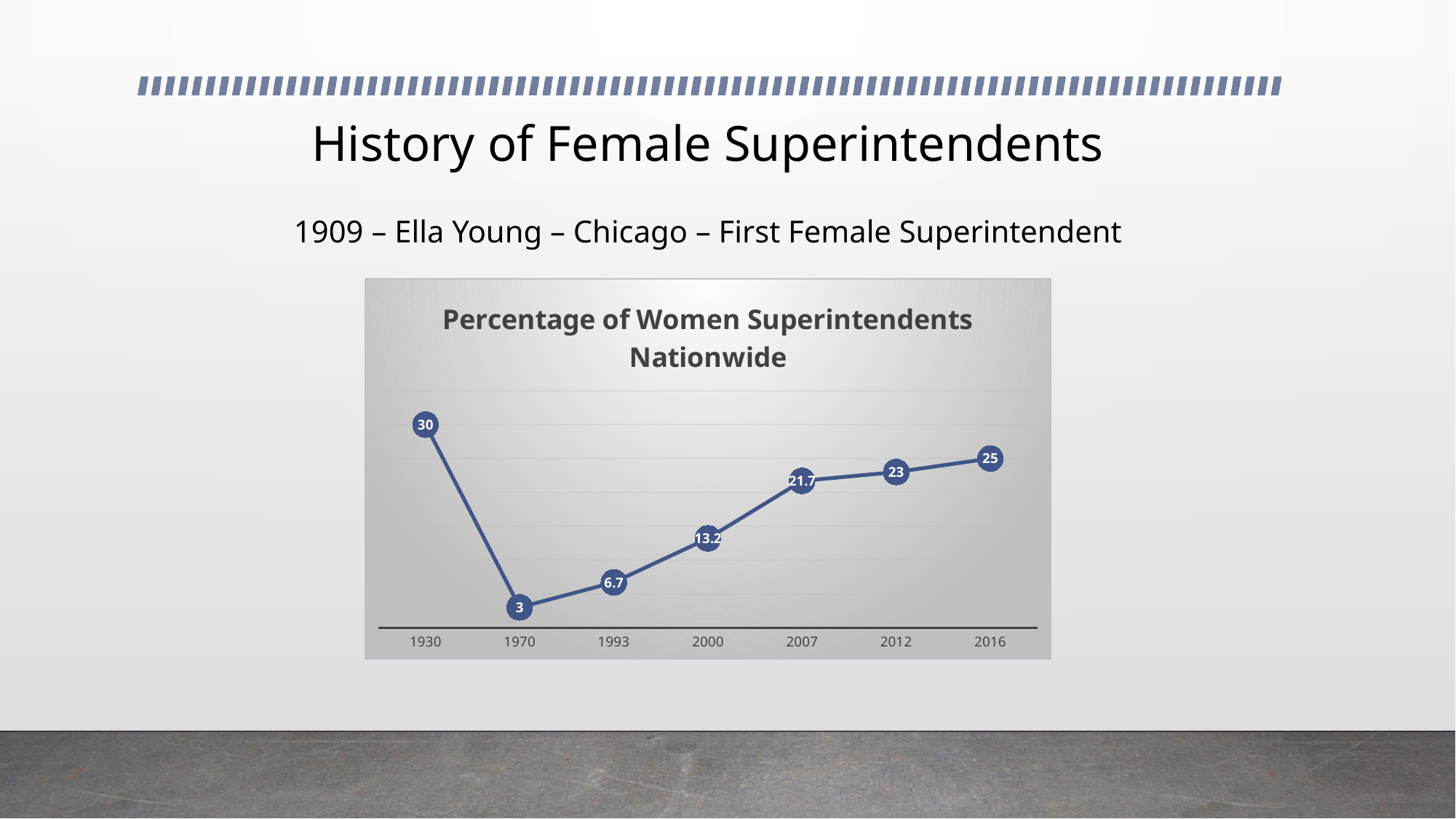
What is the title of the chart? Percentage of Women Superintendents Nationwide What kind of chart is shown on the slide? line chart Which year has the highest value? 1930 What is the value for 1970? 3 What is the value for 1930? 30 What is the value for 2016? 25 What is the value for 2000? 13.2 Which year has the lowest value? 1970 What is the difference between the values for 2007 and 1993? 15 Do the values rise or fall from 1970 to 2016? rise Which is larger, the value for 2012 or the value for 2000? 2012 How many data points are plotted on the chart? 7